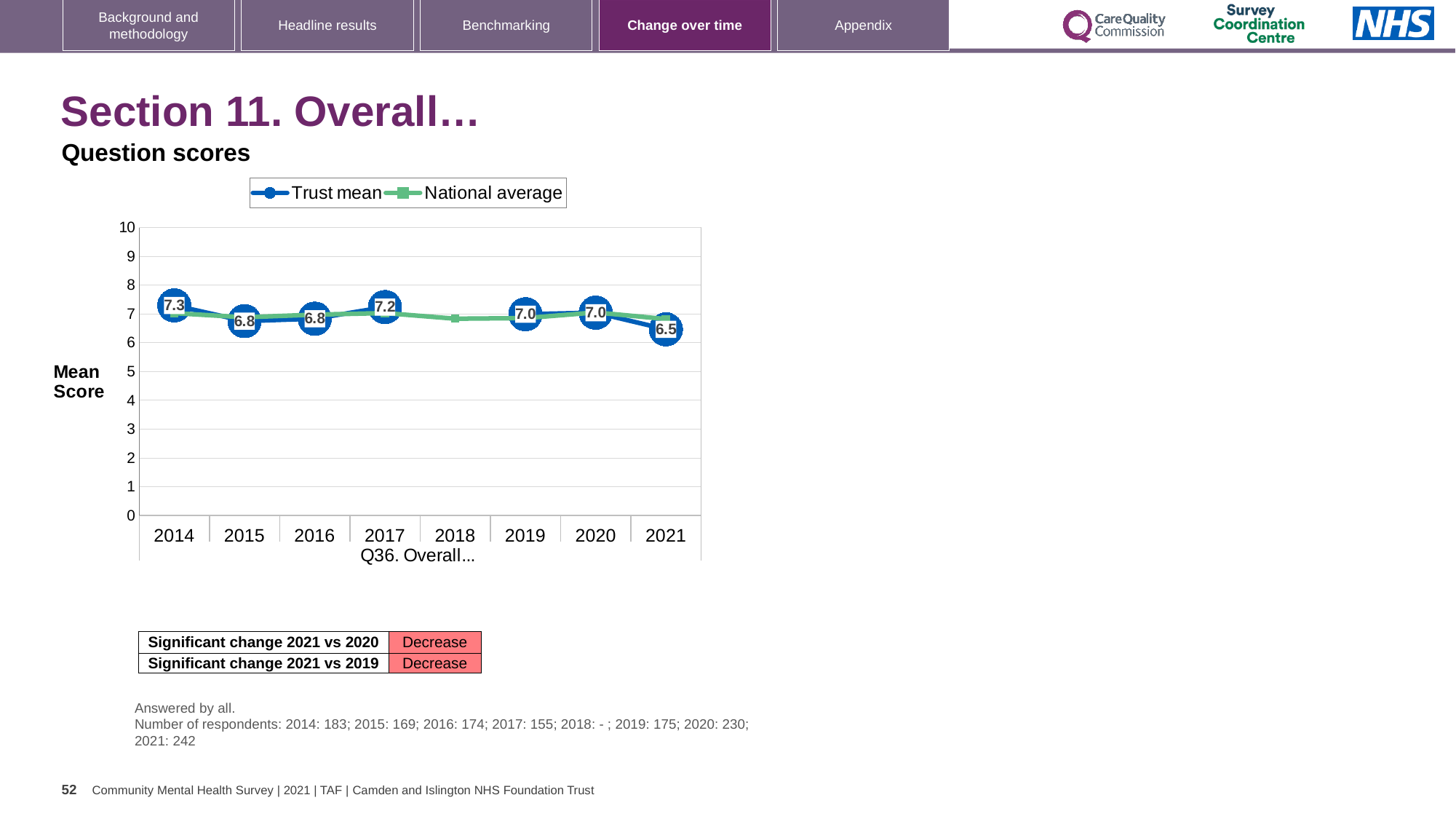
What is the Trust mean value for 2014? 7.3 What kind of chart is shown? line chart What is the difference between the Trust mean in 2014 and in 2021? 0.8 What is the Trust mean value for 2021? 6.5 Does the Trust mean rise or fall from 2020 to 2021? fall In which year is the Trust mean highest? 2014 How many years are shown on the x axis? 8 Which is larger, the Trust mean for 2017 or for 2015? 2017 How many series does the legend list? 2 In which year is the Trust mean lowest? 2021 What is the Trust mean value for 2017? 7.2 Is the National average value for 2018 greater or less than 6? greater